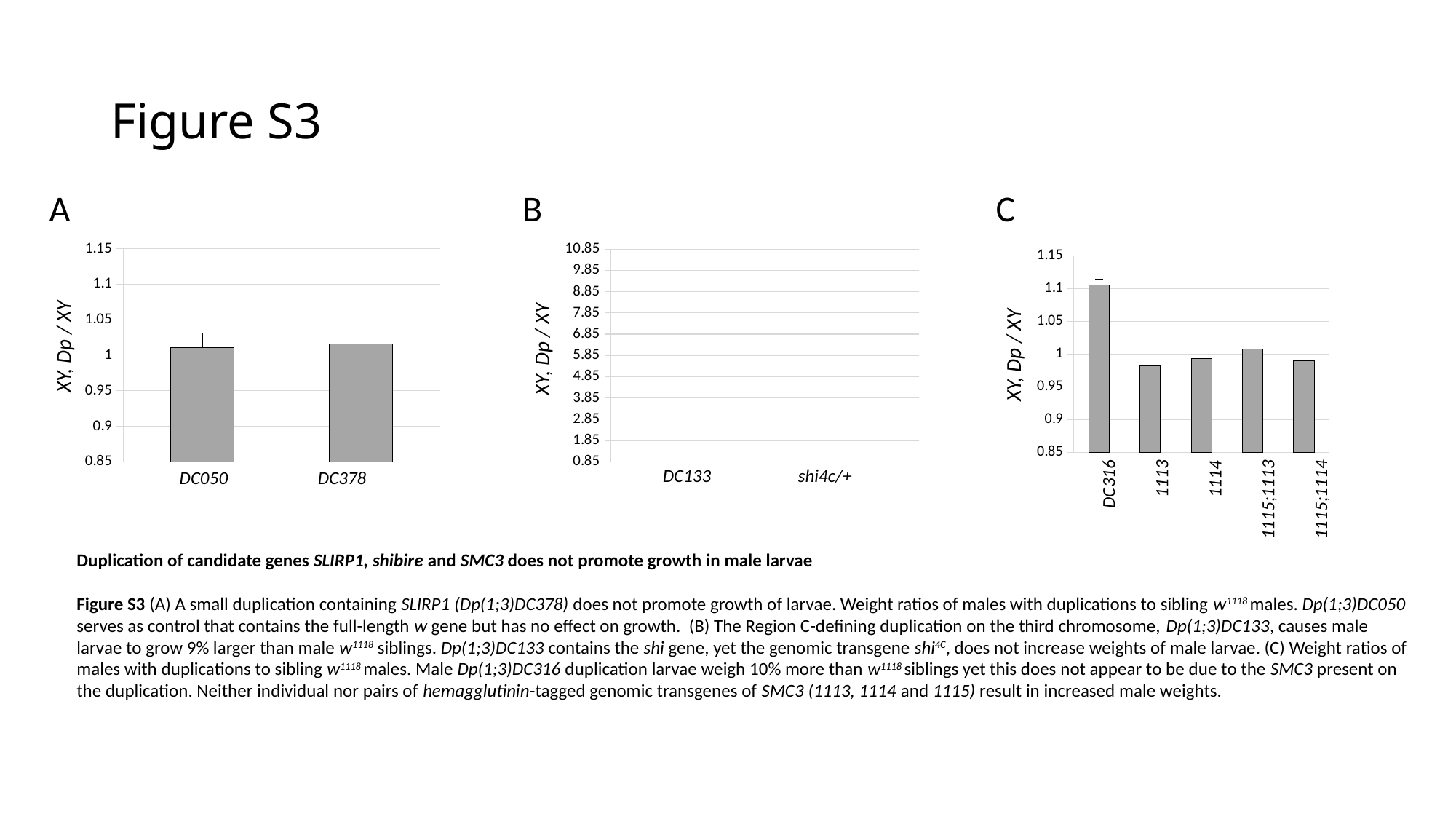
In chart C, which is larger, the value for DC316 or the value for 1114? DC316 In chart C, which category has the highest value? DC316 How many bars are shown in chart C? 5 In chart C, is the value for 1113 greater or less than 1? less What kind of chart is chart A? bar chart What is the y-axis label of chart A? XY, Dp / XY How many categories are labelled on the x axis of chart B? 2 In chart A, is the value for DC378 greater or less than 1.05? less In chart C, is the value for DC316 greater or less than 1.05? greater What is the highest tick value shown on the y axis of chart B? 10.85 How many categories are shown on the x axis of chart A? 2